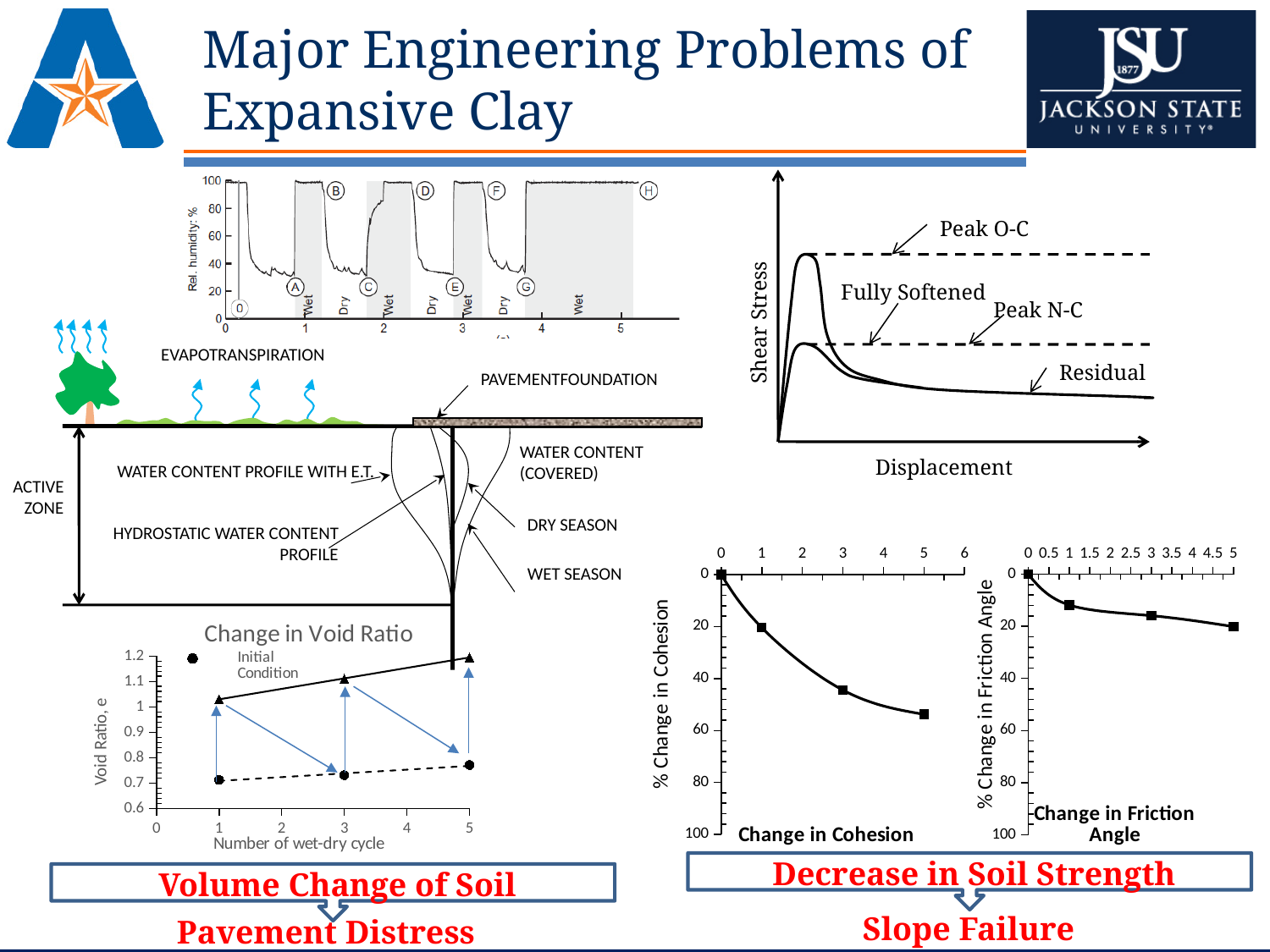
In the Shear Stress versus Displacement chart, which labelled curve level is the lowest at large displacement? Residual In the Change in Void Ratio chart, what is the x-axis label? Number of wet-dry cycle In the Change in Void Ratio chart, is the void ratio of the triangle marker at wet-dry cycle 5 greater or less than 1.1? greater What kind of chart is the Change in Cohesion chart? line chart In the Change in Void Ratio chart, is the void ratio of the circle marker at wet-dry cycle 1 greater or less than 0.8? less What is the title of the bottom-left chart? Change in Void Ratio In the Change in Void Ratio chart, do the triangle-marker void ratios rise or fall as the number of wet-dry cycles increases? rise In the Change in Cohesion chart, is the % change in cohesion at x = 1 greater or less than 40? less How many data points are plotted in the Change in Friction Angle chart? 4 How many data points are plotted in the Change in Cohesion chart? 4